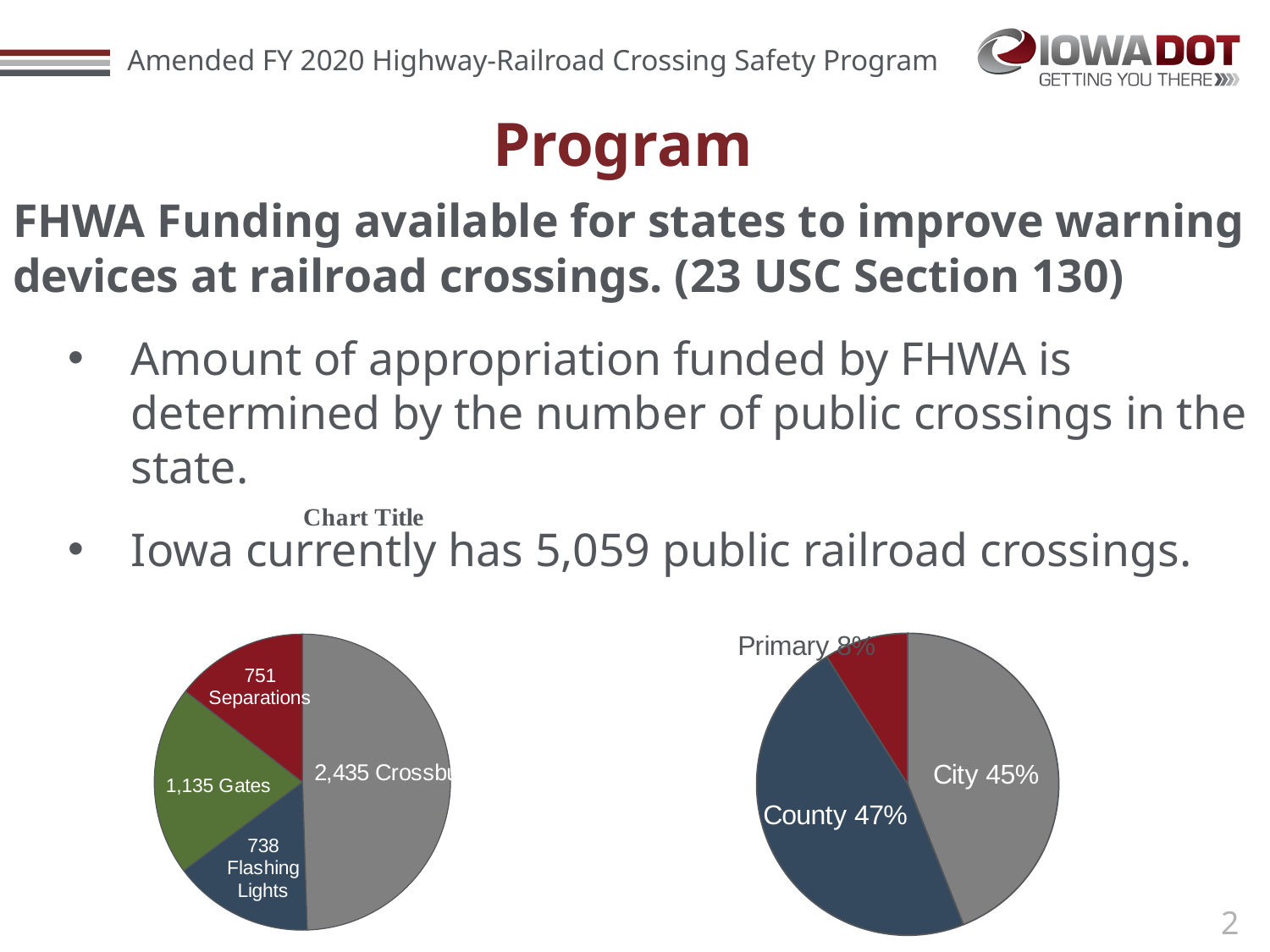
In the right pie chart, what share is shown for City? 45% In the left pie chart, what is the value printed on the largest (grey) slice? 2,435 In the left pie chart, what is the value shown for Flashing Lights? 738 In the right pie chart, which category has the largest share? County In the left pie chart, what is the value shown for Gates? 1,135 In the right pie chart, what share is shown for County? 47% In the left pie chart, what is the value shown for Separations? 751 In the left pie chart, what is the difference between the Gates value and the Flashing Lights value? 397 What type of chart is the right chart on the slide? Pie chart How many slices does the left pie chart have? 4 In the left pie chart, which is larger, Gates or Separations? Gates In the right pie chart, which category has the smallest share? Primary